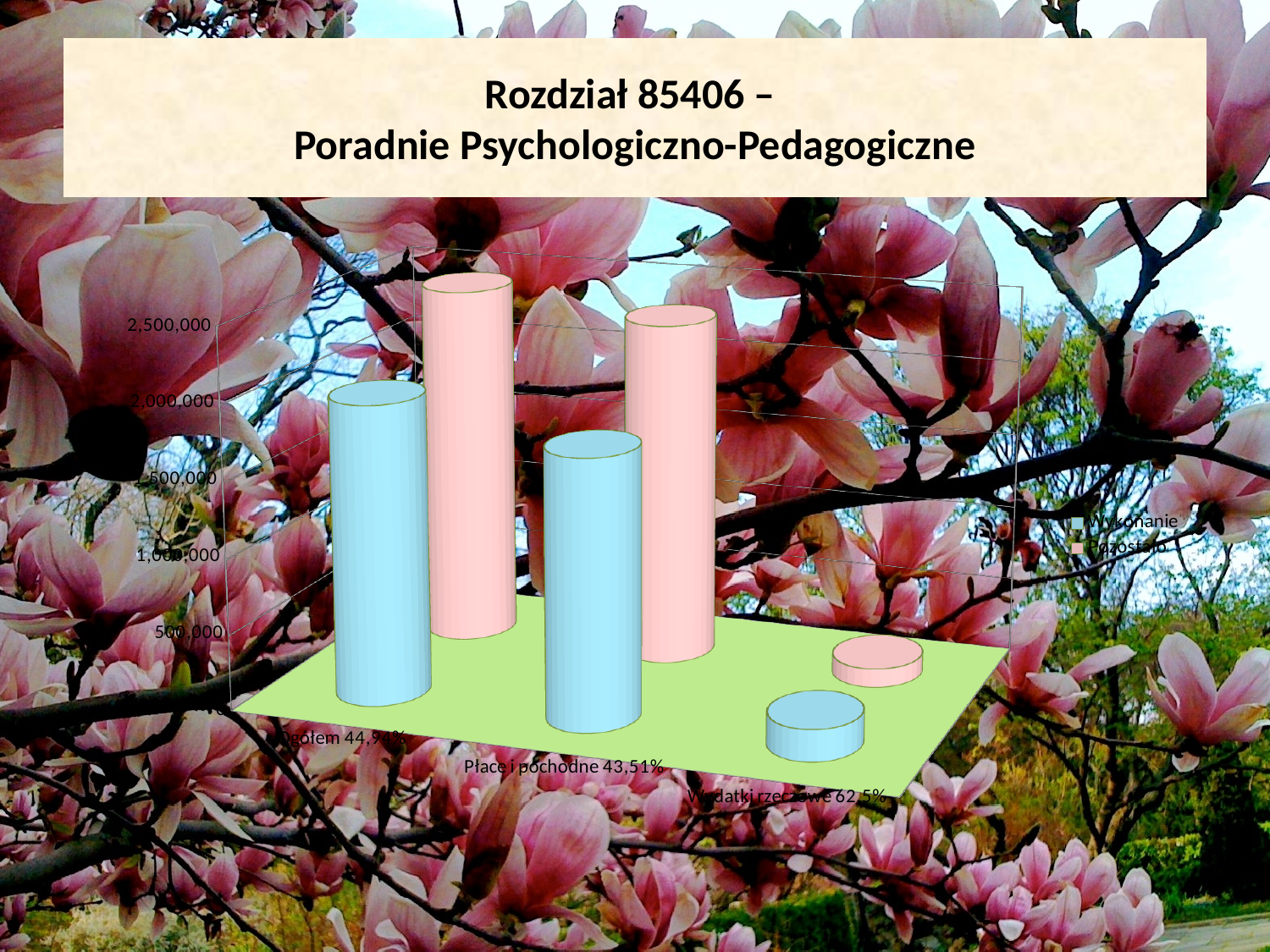
How many series does the chart's legend list? 2 Which category has the lowest Wykonanie value? Wydatki rzeczowe 62,5% Is the Wykonanie value for Wydatki rzeczowe 62,5% greater or less than 500,000? less For Ogółem 44,94%, which is larger: Wykonanie or Pozostało? Pozostało Which category has the lowest Pozostało value? Wydatki rzeczowe 62,5% Is the Pozostało value for Ogółem 44,94% greater or less than 1,500,000? greater Which category has the highest Wykonanie value? Ogółem 44,94% How many categories are shown on the chart's x axis? 3 Is the Wykonanie value for Płace i pochodne 43,51% greater or less than 1,000,000? greater What kind of chart is shown on the slide? bar chart What is the title shown above the chart? Rozdział 85406 – Poradnie Psychologiczno-Pedagogiczne What are the two series named in the chart's legend? Wykonanie and Pozostało